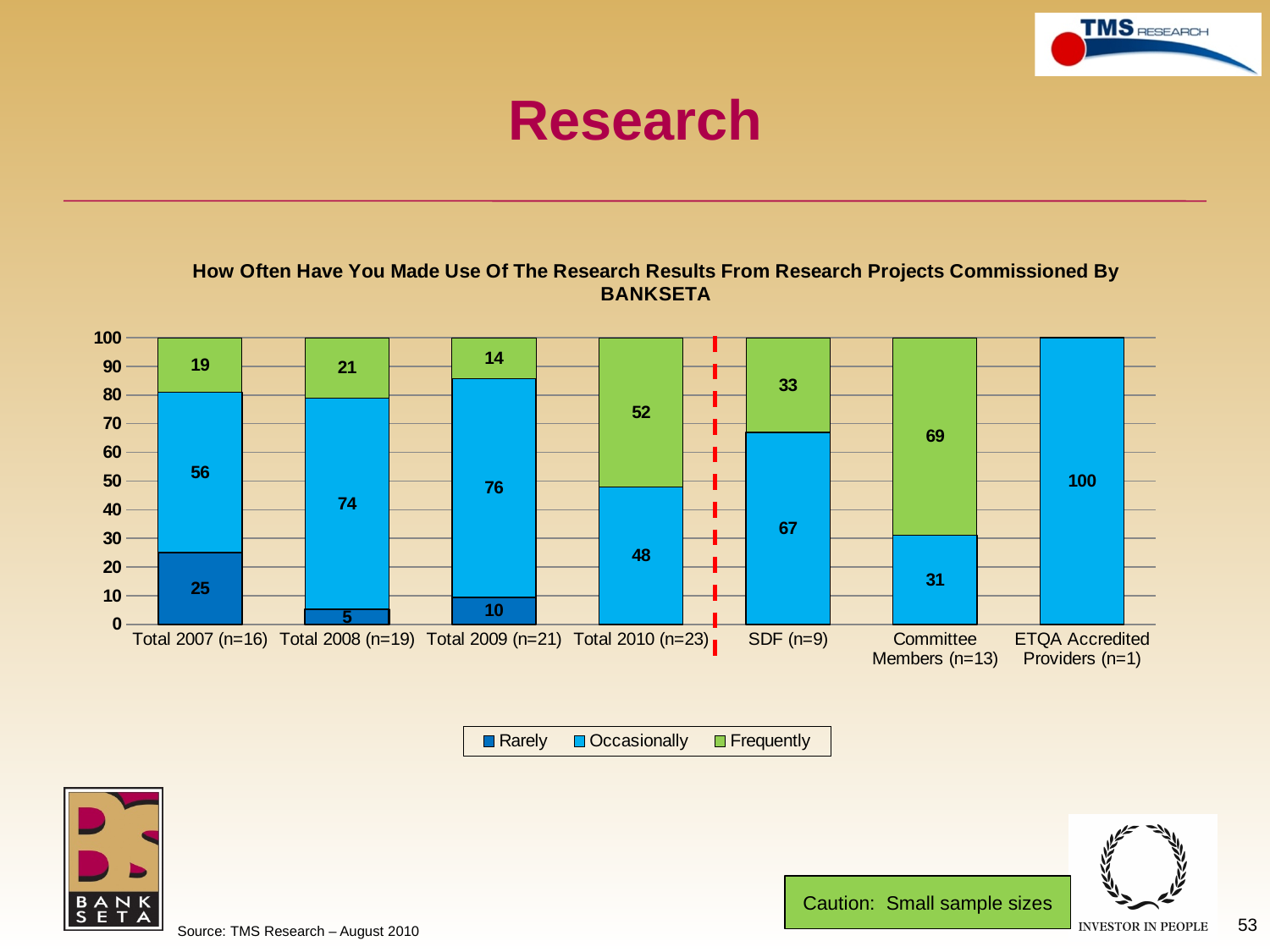
What is the total of the stacked bar for Total 2007 (n=16)? 100 What kind of chart is this? Stacked bar chart What is the Rarely value for Total 2007 (n=16)? 25 What is the Occasionally value for Total 2008 (n=19)? 74 Which is larger, the Frequently value for SDF (n=9) or the Frequently value for Total 2010 (n=23)? Total 2010 (n=23) Which category has the highest Frequently value? Committee Members (n=13) Which category has the lowest Rarely value among those with a Rarely segment? Total 2008 (n=19) What is the difference between the Occasionally values for Total 2009 (n=21) and Total 2010 (n=23)? 28 Which series is shown in green in the legend? Frequently How many categories are shown on the x axis? 7 What is the Frequently value for Committee Members (n=13)? 69 How many series does the legend list? 3